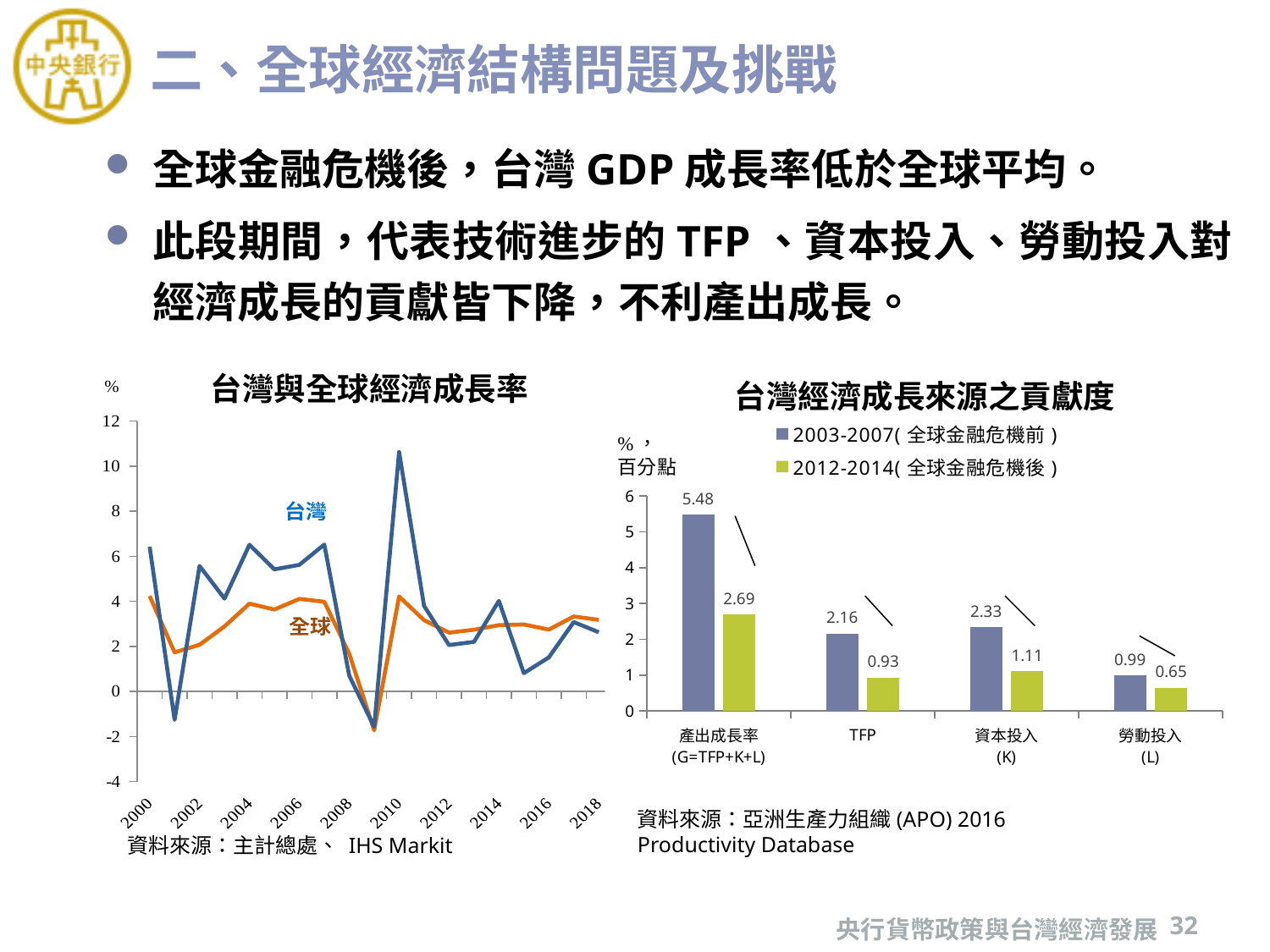
In the chart titled 台灣經濟成長來源之貢獻度, what is the value for TFP in 2012-2014( 全球金融危機後 )? 0.93 In the chart titled 台灣經濟成長來源之貢獻度, how many series does the legend list? 2 In the chart titled 台灣經濟成長來源之貢獻度, which category has the highest value in the 2003-2007( 全球金融危機前 ) series? 產出成長率 (G=TFP+K+L) In the chart titled 台灣經濟成長來源之貢獻度, how many categories are shown on the x axis? 4 What kind of chart is the chart titled 台灣與全球經濟成長率? line chart In the chart titled 台灣經濟成長來源之貢獻度, which category has the lowest value in the 2012-2014( 全球金融危機後 ) series? 勞動投入 (L) In the chart titled 台灣經濟成長來源之貢獻度, which is larger for TFP: the 2003-2007( 全球金融危機前 ) value or the 2012-2014( 全球金融危機後 ) value? 2003-2007( 全球金融危機前 ) In the chart titled 台灣與全球經濟成長率, is the value for 台灣 in 2010 greater or less than 8? greater In the chart titled 台灣經濟成長來源之貢獻度, what is the value for 產出成長率 (G=TFP+K+L) in 2003-2007( 全球金融危機前 )? 5.48 In the chart titled 台灣經濟成長來源之貢獻度, what is the difference between the 2003-2007 and 2012-2014 values for 產出成長率 (G=TFP+K+L)? 2.79 In the chart titled 台灣經濟成長來源之貢獻度, what is the value for 勞動投入 (L) in 2012-2014( 全球金融危機後 )? 0.65 In the chart titled 台灣經濟成長來源之貢獻度, what is the value for 資本投入 (K) in 2003-2007( 全球金融危機前 )? 2.33